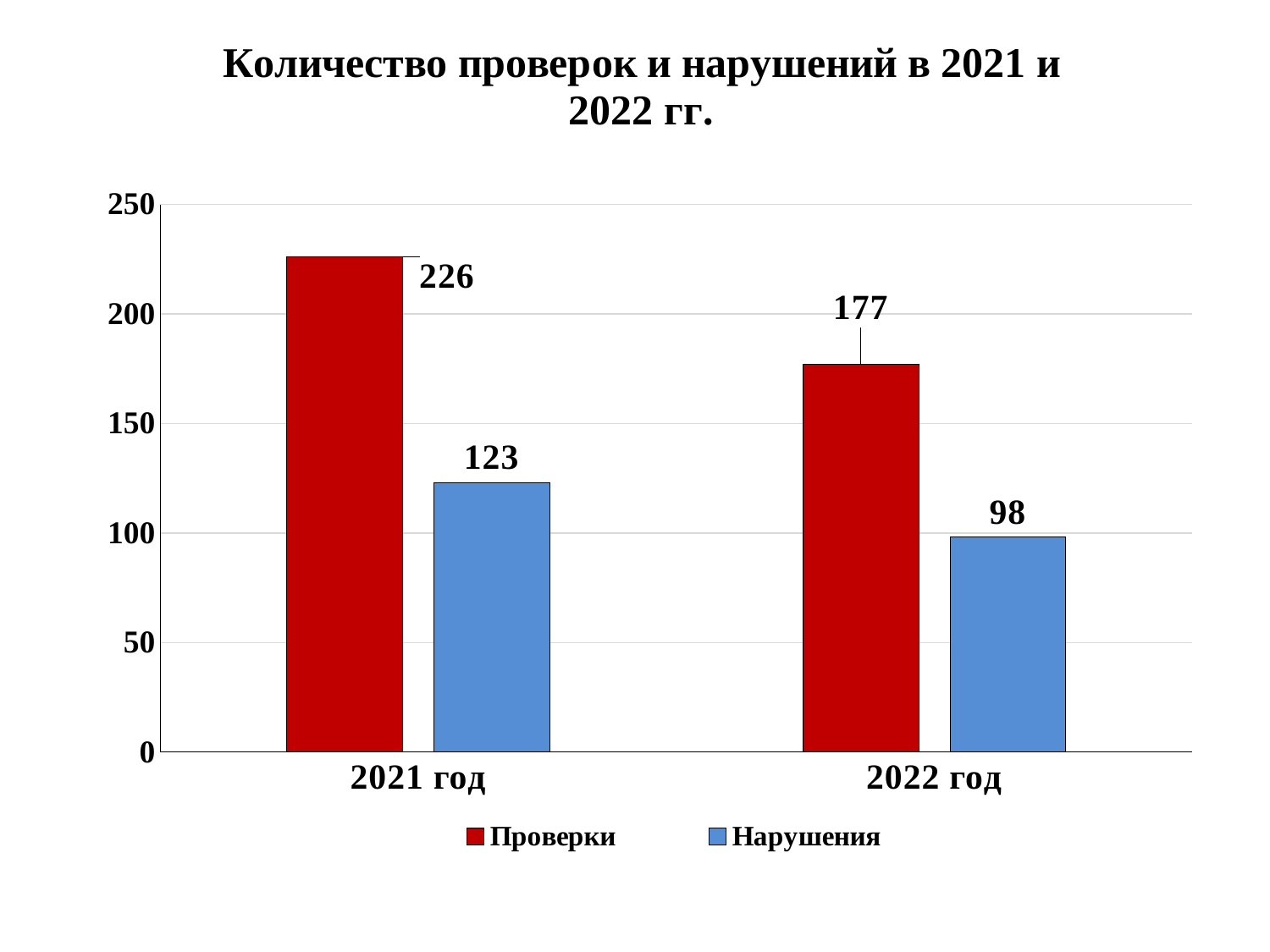
What is the difference between Проверки and Нарушения in 2021 год? 103 Which year has the lowest value for Нарушения? 2022 год What is the value of Проверки for 2022 год? 177 How many series does the legend list? 2 Do the values for Нарушения rise or fall from 2021 год to 2022 год? Fall What is the difference between Проверки in 2021 год and 2022 год? 49 What kind of chart is shown on the slide? Bar chart What is the value of Проверки for 2021 год? 226 What is the value of Нарушения for 2022 год? 98 What is the value of Нарушения for 2021 год? 123 Which year has the highest value for Проверки? 2021 год Which is larger: Нарушения in 2021 год or Проверки in 2022 год? Проверки in 2022 год